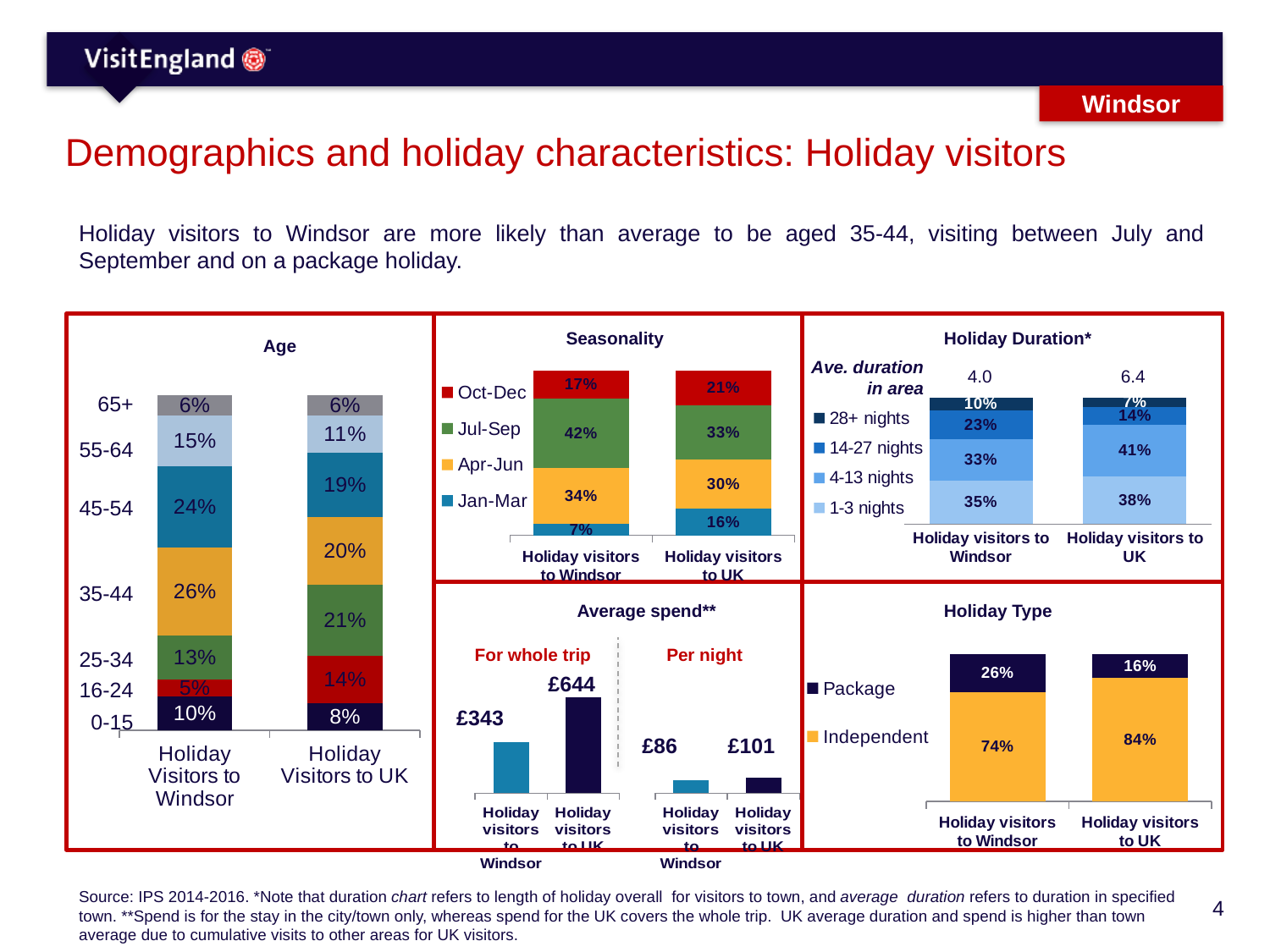
In the Age chart, which age group has the largest share among holiday visitors to UK? 25-34 In the Seasonality chart, what is the difference between the Jan-Mar share for holiday visitors to UK and for holiday visitors to Windsor? 9% In the Average spend chart, what is the spend for the whole trip for holiday visitors to UK? £644 What type of chart is the Holiday Type chart? Stacked bar chart In the Holiday Type chart, what percentage of holiday visitors to Windsor are on a package holiday? 26% In the Holiday Duration chart, what share of holiday visitors to UK stay 4-13 nights? 41% In the Average spend chart, what is the difference in per night spend between holiday visitors to UK and holiday visitors to Windsor? £15 In the Age chart, what share of holiday visitors to Windsor are aged 35-44? 26% In the Holiday Duration chart, which is larger: the 28+ nights share for holiday visitors to Windsor or for holiday visitors to UK? Holiday visitors to Windsor In the Seasonality chart, how many series does the legend list? 4 In the Holiday Duration chart, what is the average duration in area for holiday visitors to Windsor? 4.0 In the Seasonality chart, what percentage of holiday visitors to Windsor visit in Jul-Sep? 42%